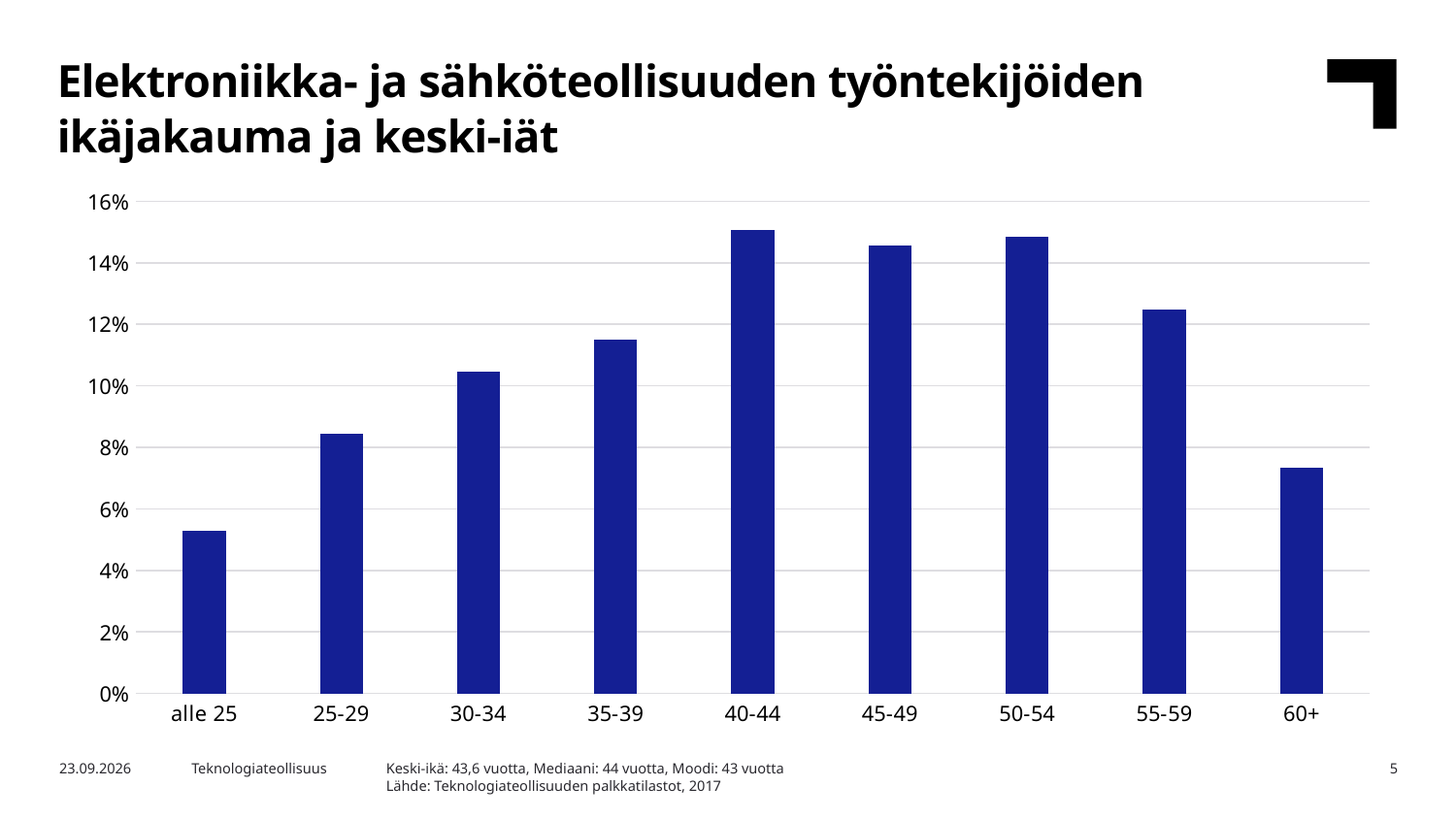
Which has a larger share, alle 25 or 60+? 60+ What kind of chart is shown on the slide? bar chart How many age groups are shown on the x axis? 9 Is the value for 40-44 greater or less than 14%? greater Which age group has the lowest share? alle 25 Is the value for alle 25 greater or less than 6%? less Which has a larger share, 25-29 or 55-59? 55-59 Is the value for 55-59 greater or less than 12%? greater What is the title of the chart on the slide? Elektroniikka- ja sähköteollisuuden työntekijöiden ikäjakauma ja keski-iät Do the values rise or fall from alle 25 to 40-44? rise